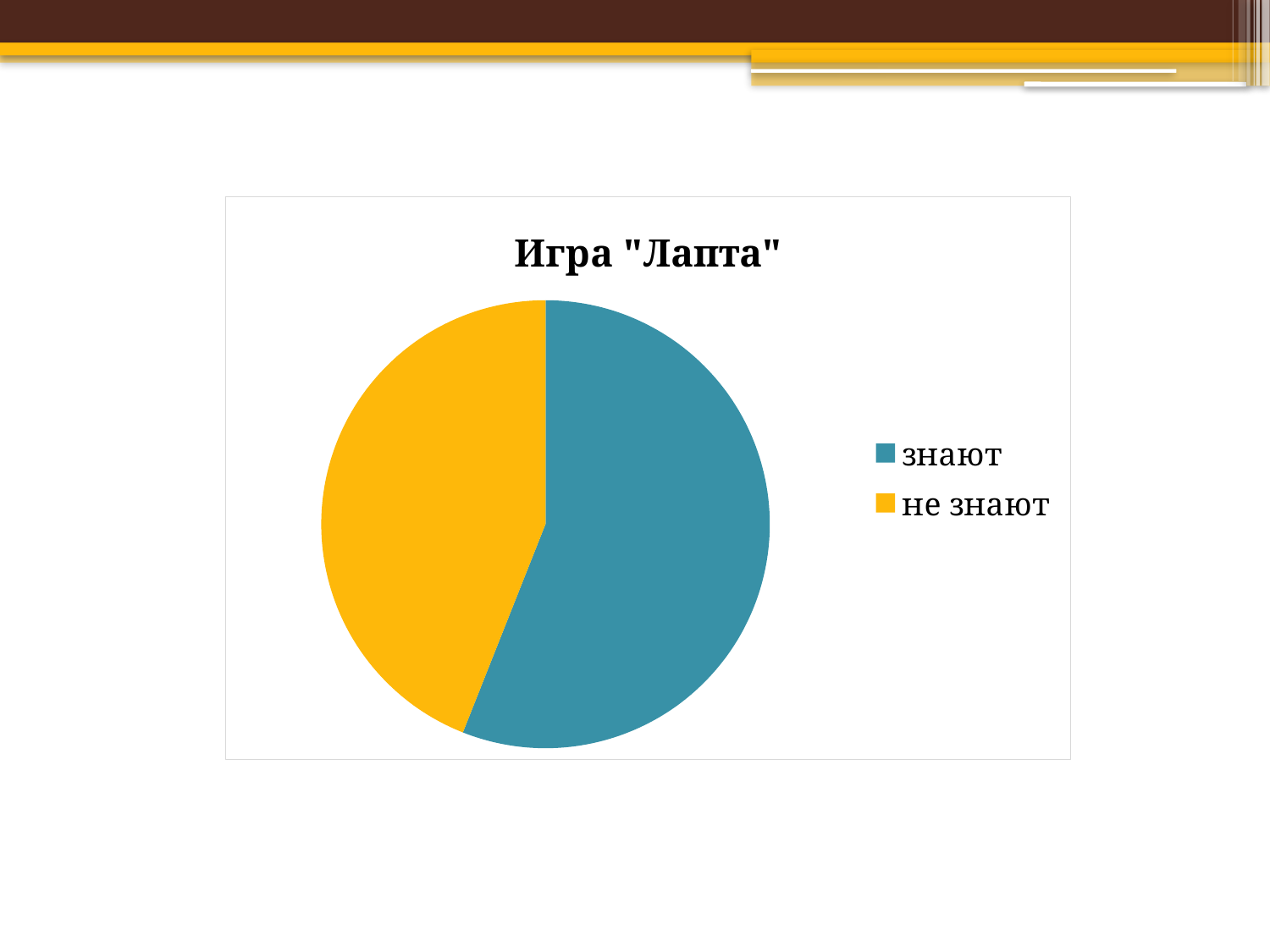
What colour is the не знают slice? yellow How many entries does the legend list? 2 What is the title of the chart? Игра "Лапта" Which slice is the smallest in the pie chart? не знают Does the знают slice take up more or less than half of the pie? more How many slices does the pie chart have? 2 Which slice is the largest in the pie chart? знают What kind of chart is shown on the slide? pie chart Which slice is larger, знают or не знают? знают